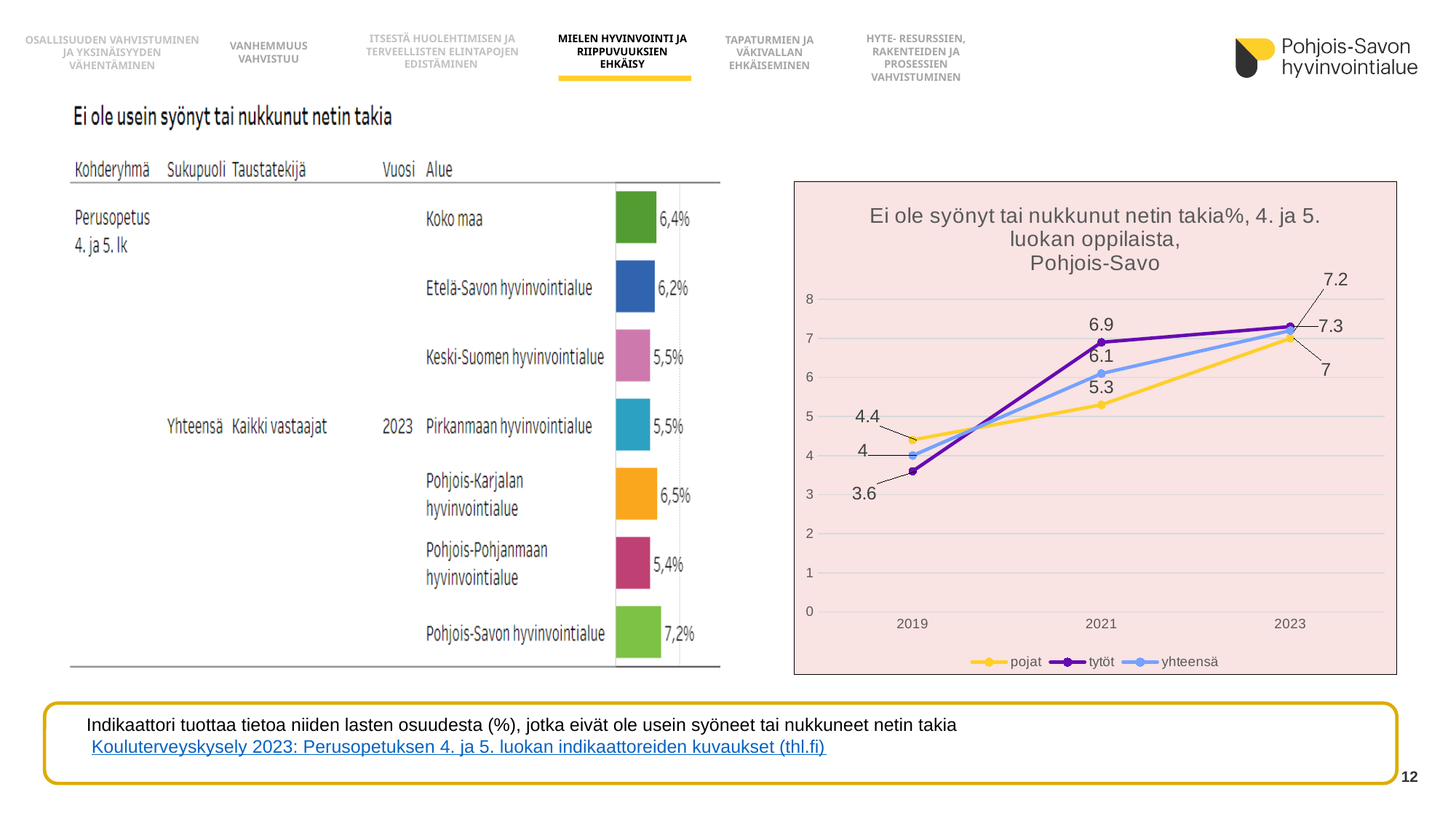
In the left chart, how many areas are shown? 7 In the right chart (Pohjois-Savo), what is the value for pojat in 2023? 7 In the left chart, what is the value for Pohjois-Savon hyvinvointialue? 7,2% In the right chart (Pohjois-Savo), which series has the lowest value in 2019? tytöt In the left chart, what is the value for Koko maa? 6,4% In the left chart, what is the difference between Pohjois-Savon hyvinvointialue and Koko maa? 0,8% In the left chart, which area has the lowest value? Pohjois-Pohjanmaan hyvinvointialue In the right chart (Pohjois-Savo), how many series does the legend list? 3 In the left chart, which area has the highest value? Pohjois-Savon hyvinvointialue In the right chart (Pohjois-Savo), do the values for yhteensä rise or fall from 2019 to 2023? rise In the right chart (Pohjois-Savo), what is the value for tytöt in 2021? 6.9 In the right chart (Pohjois-Savo), what is the value for pojat in 2019? 4.4